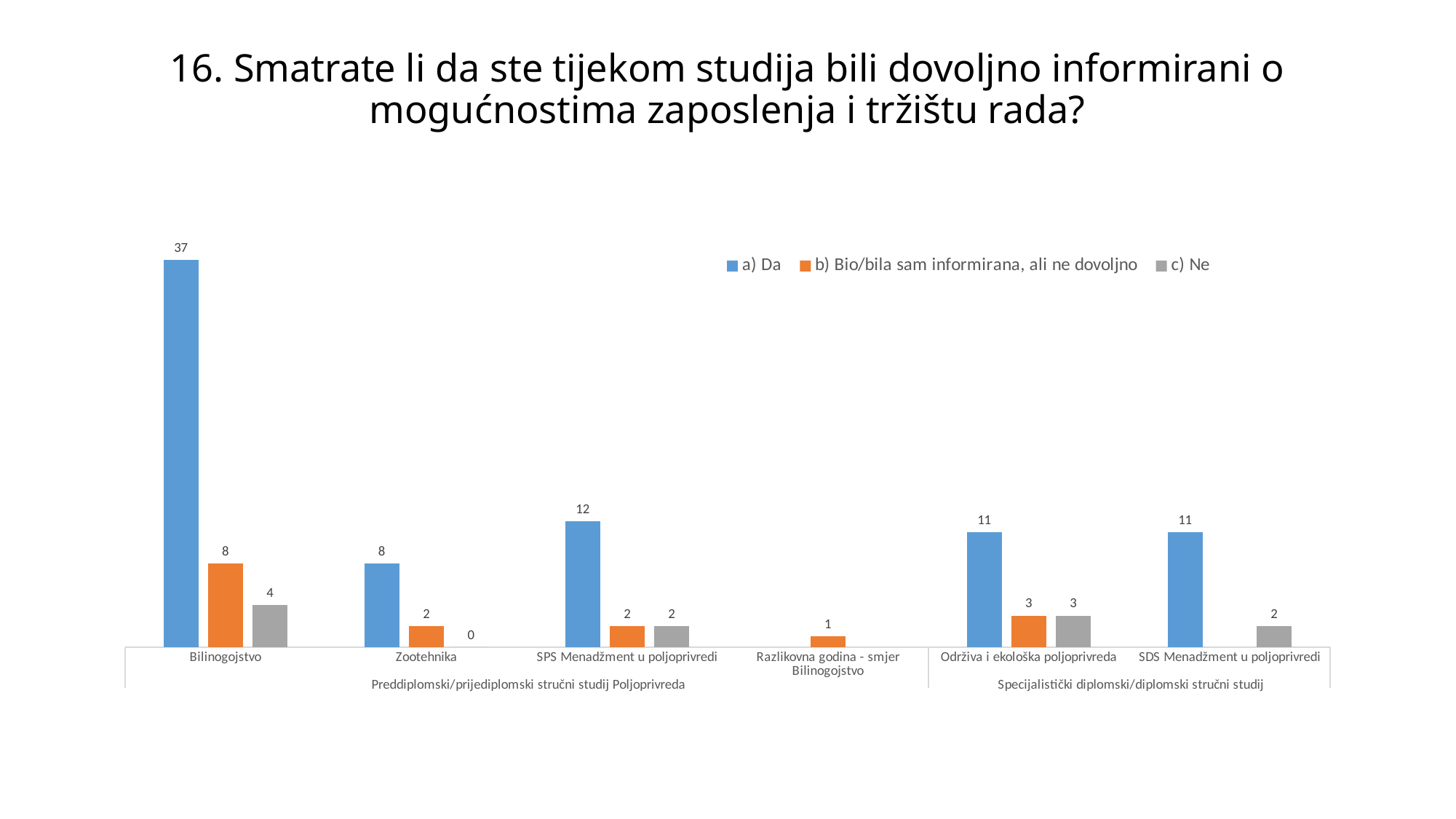
Which is larger: the "c) Ne" value for Bilinogojstvo or for Održiva i ekološka poljoprivreda? Bilinogojstvo What colour represents the series "c) Ne"? Grey Which category has the highest value for "a) Da"? Bilinogojstvo What is the value of "a) Da" for SPS Menadžment u poljoprivredi? 12 What is the value of "b) Bio/bila sam informirana, ali ne dovoljno" for Razlikovna godina - smjer Bilinogojstvo? 1 Which category has the highest value for "b) Bio/bila sam informirana, ali ne dovoljno"? Bilinogojstvo What kind of chart is shown on the slide? Bar chart What is the difference between the "a) Da" values for Bilinogojstvo and Zootehnika? 29 How many categories are shown on the x axis? 6 How many series does the legend list? 3 What is the value of "a) Da" for Bilinogojstvo? 37 What is the value of "c) Ne" for Zootehnika? 0